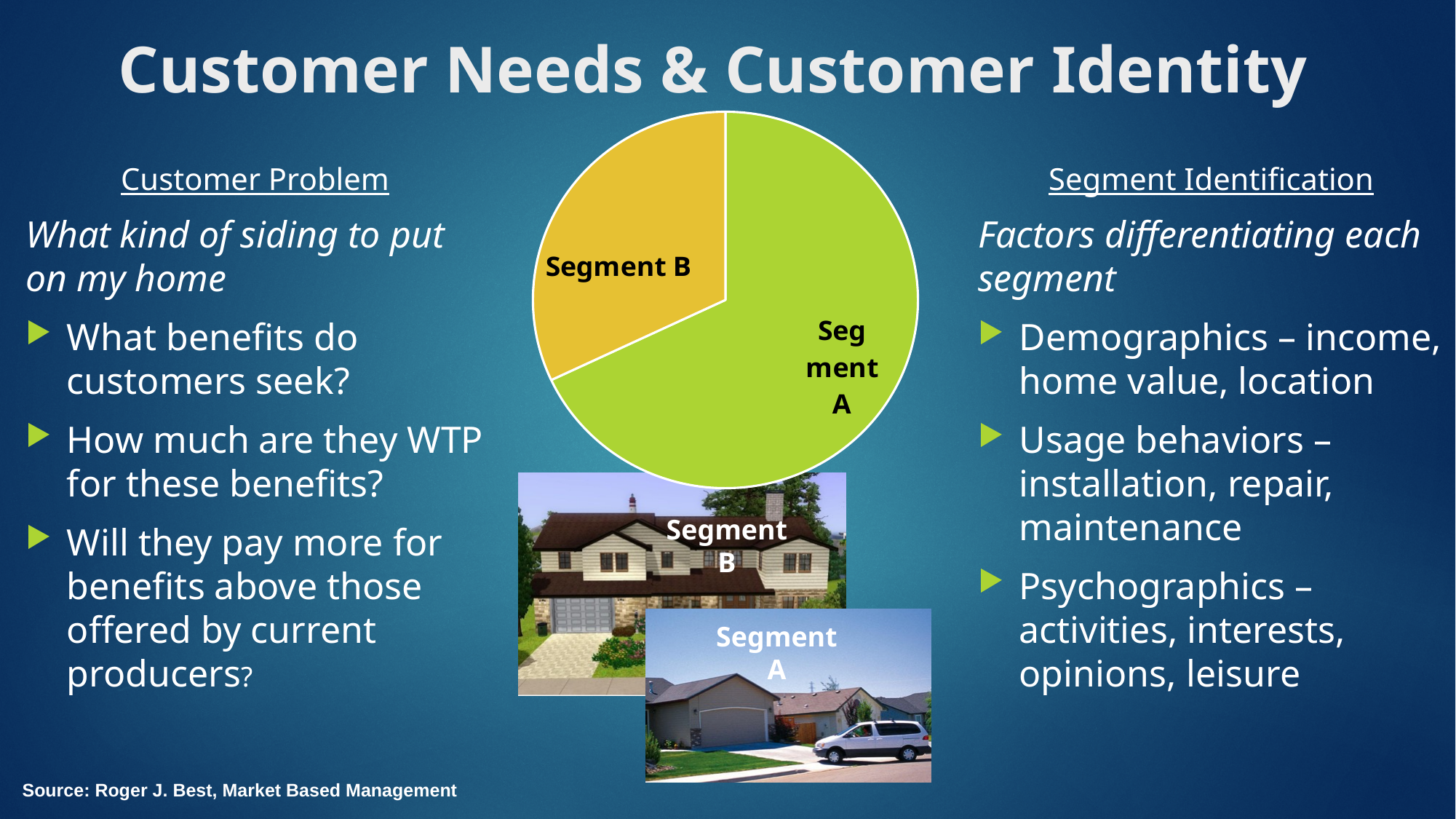
Which segment has the smallest slice of the pie chart? Segment B Which segment has the largest slice of the pie chart? Segment A How many slices does the pie chart have? 2 Which slice is larger in the pie chart, Segment A or Segment B? Segment A Is the Segment A slice more or less than half of the pie chart? More What are the labels of the two slices in the pie chart? Segment A and Segment B What colour is the Segment A slice in the pie chart? Green What kind of chart is shown on the slide? Pie chart What colour is the Segment B slice in the pie chart? Yellow